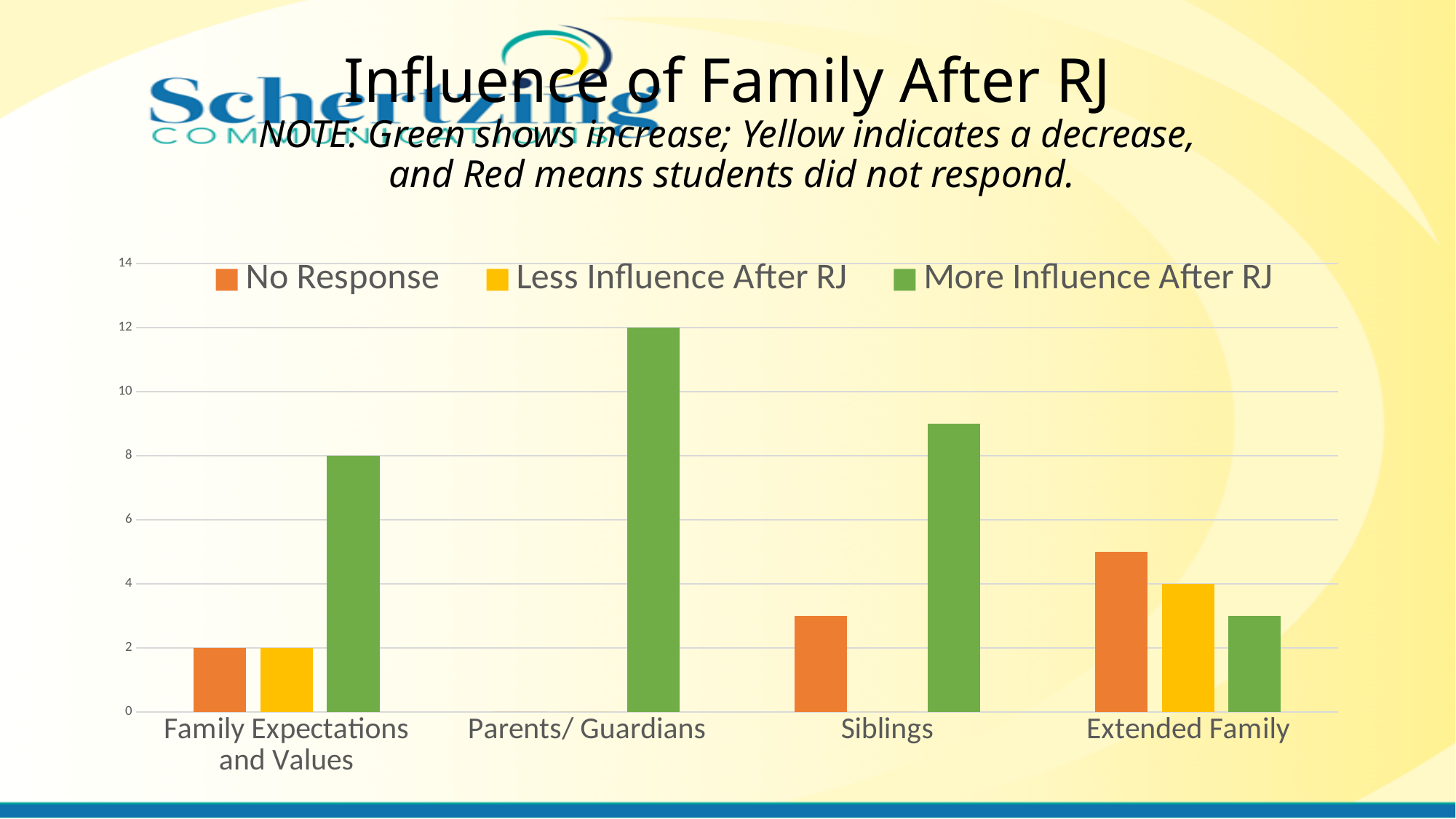
Which is larger for Extended Family: No Response or More Influence After RJ? No Response Which category has the highest More Influence After RJ value? Parents/ Guardians Which category has the lowest More Influence After RJ value? Extended Family How many categories are shown on the x axis? 4 What is the value of Less Influence After RJ for Extended Family? 4 What is the value of More Influence After RJ for Parents/ Guardians? 12 Which legend entry is shown in green? More Influence After RJ How many series does the legend list? 3 What is the value of More Influence After RJ for Family Expectations and Values? 8 What kind of chart is shown on the slide? Bar chart